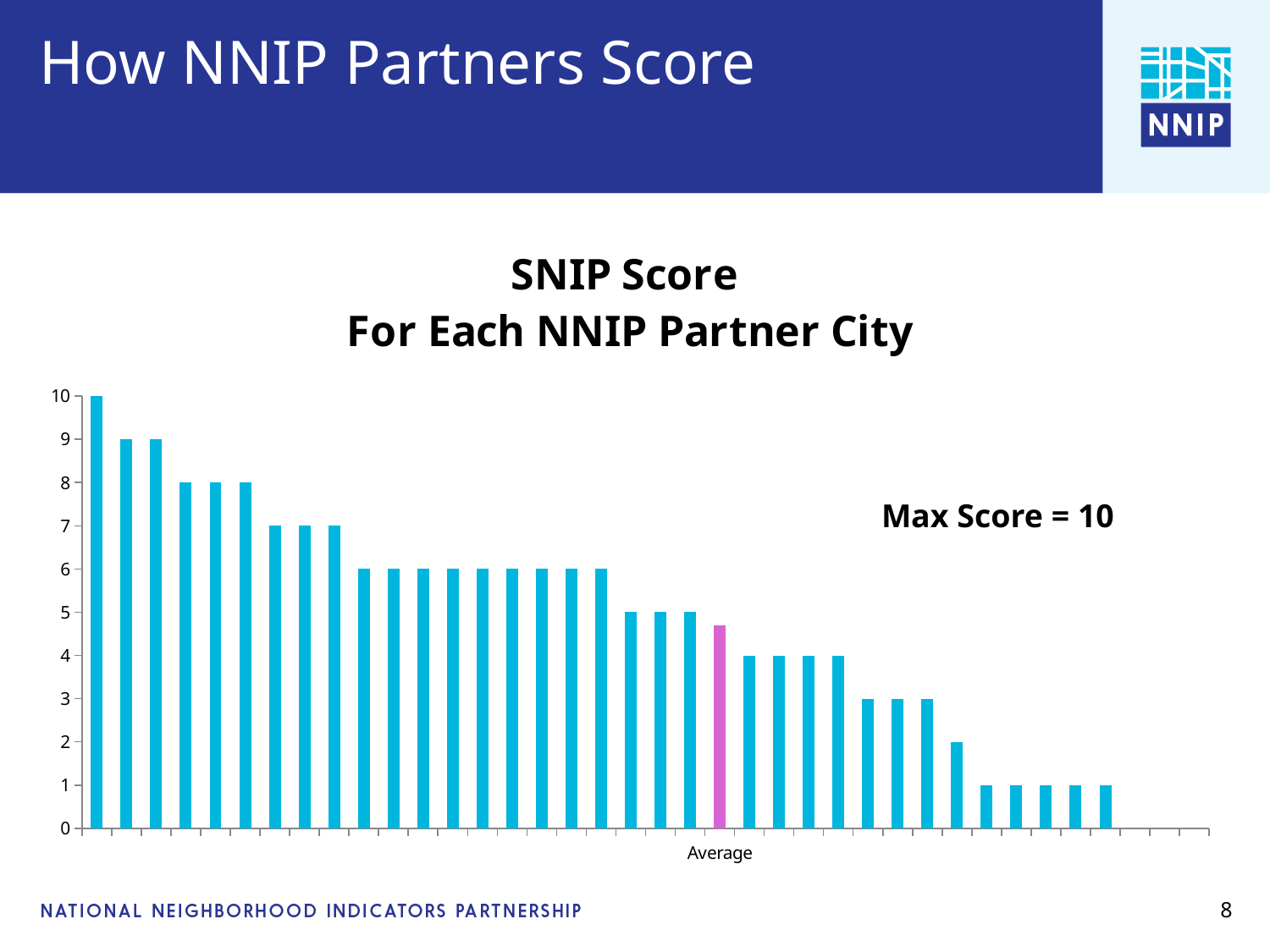
What is the title of the chart? SNIP Score For Each NNIP Partner City What is the value of the leftmost bar in the chart? 10 Which is larger, the leftmost bar or the rightmost bar? the leftmost bar What maximum score does the annotation on the chart state? Max Score = 10 Is the value for Average greater or less than 5? less What kind of chart is shown on the slide? bar chart Do the bar values rise or fall from left to right along the x axis? fall What is the value of the tallest bar in the chart? 10 Is the value for Average greater or less than 4? greater